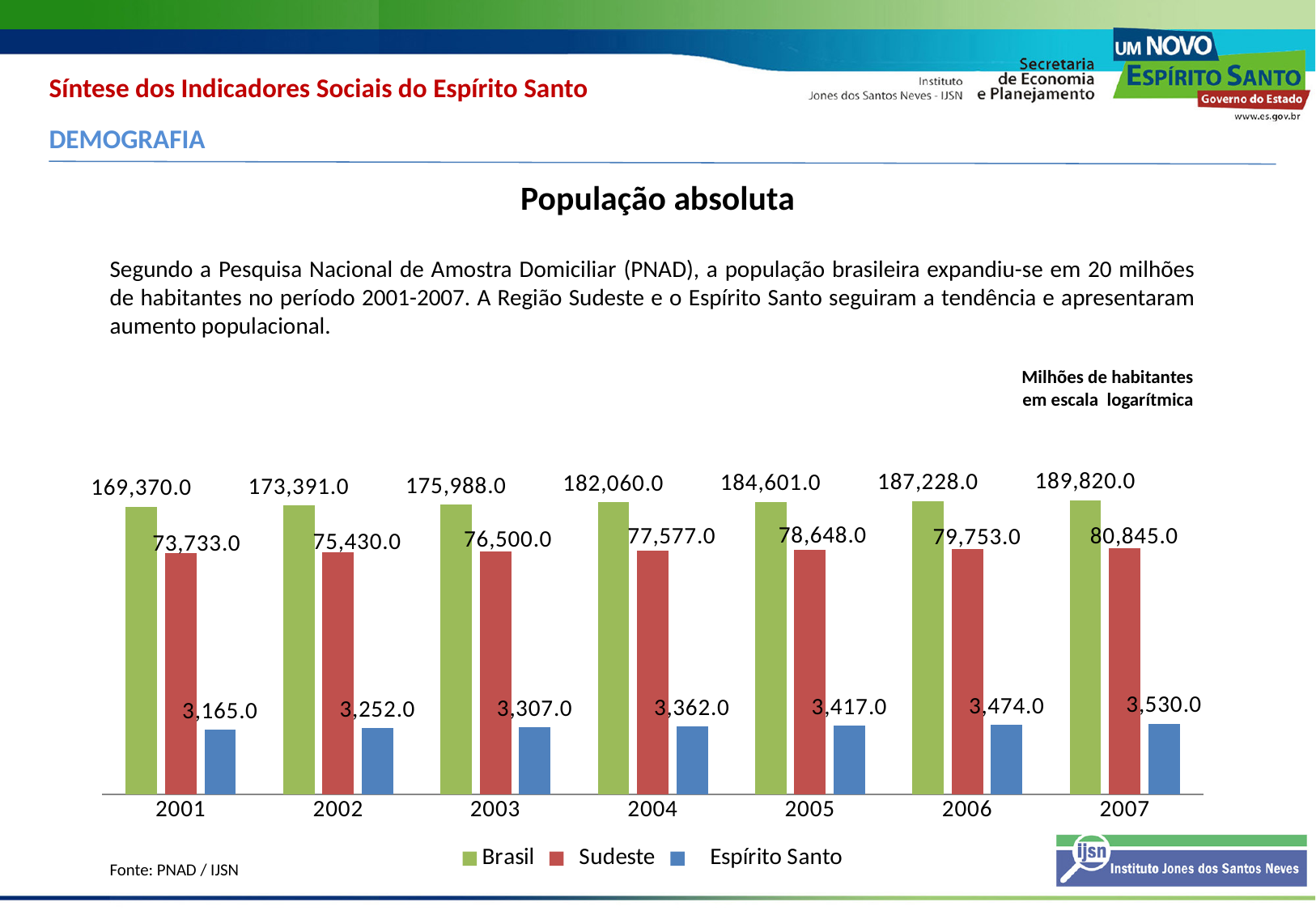
In which year is the value for Brasil highest? 2007 What is the value for Brasil in 2001? 169,370.0 How many series does the legend list? 3 Which is larger, the Sudeste value in 2005 or the Sudeste value in 2002? 2005 What kind of chart is shown on the slide? bar chart In which year is the value for Espírito Santo lowest? 2001 What is the difference between the Brasil values for 2007 and 2001? 20,450.0 What is the value for Sudeste in 2004? 77,577.0 How many years are shown on the x axis? 7 What is the difference between the Espírito Santo values for 2007 and 2001? 365.0 Do the values for Sudeste rise or fall from 2001 to 2007? rise What is the value for Espírito Santo in 2007? 3,530.0